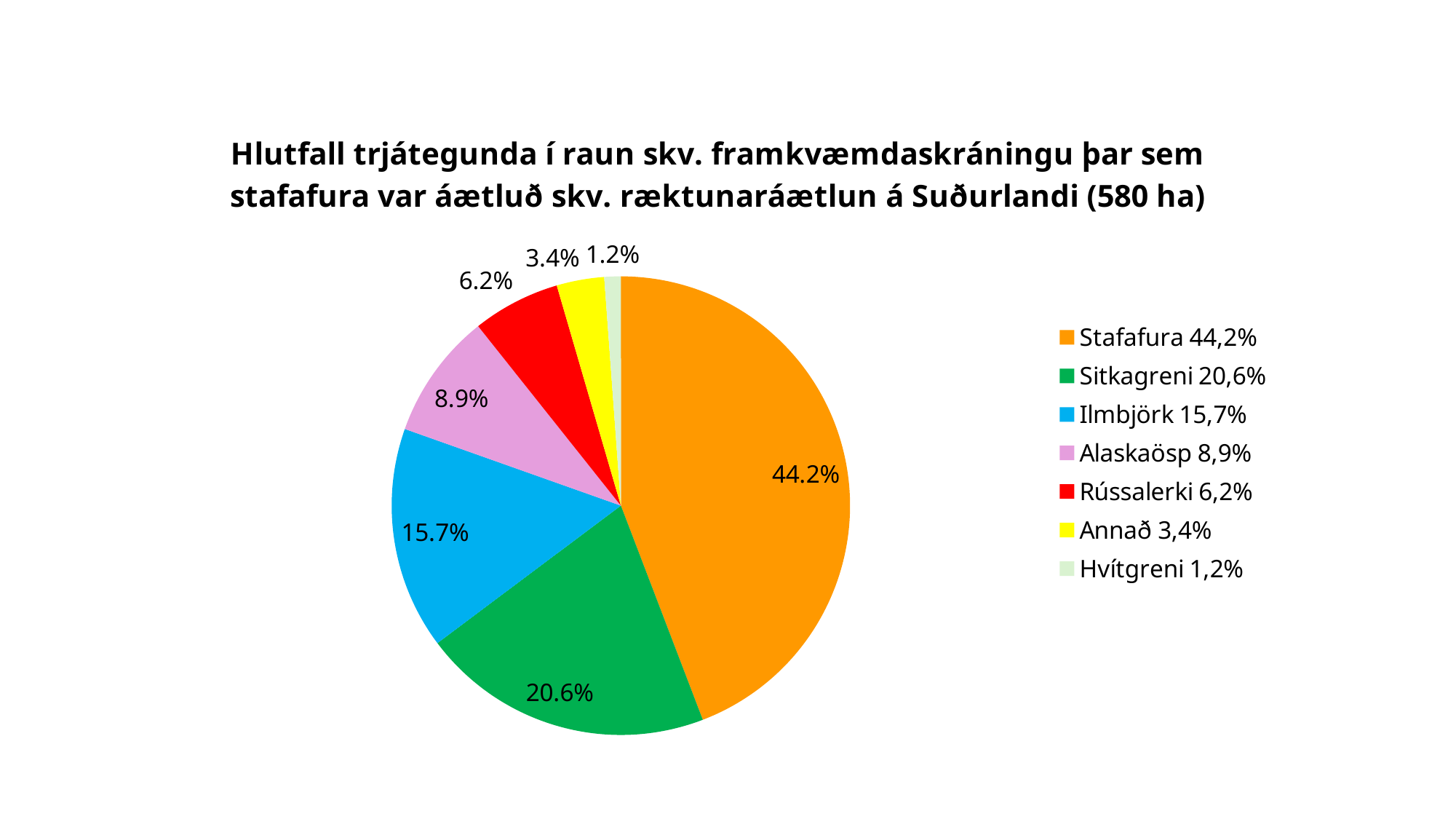
What share of the pie does Sitkagreni have? 20.6% What kind of chart is shown on the slide? pie chart What is the value shown for Rússalerki? 6.2% Which is larger, the share for Ilmbjörk or the share for Alaskaösp? Ilmbjörk What is the value shown for Alaskaösp? 8.9% Which category has the largest slice of the pie? Stafafura What is the value shown for Ilmbjörk? 15.7% How many slices does the pie chart have? 7 Which category has the smallest slice of the pie? Hvítgreni What share of the pie does Stafafura have? 44.2% What colour is the slice for Annað? yellow What is the difference between the shares of Stafafura and Sitkagreni? 23.6%